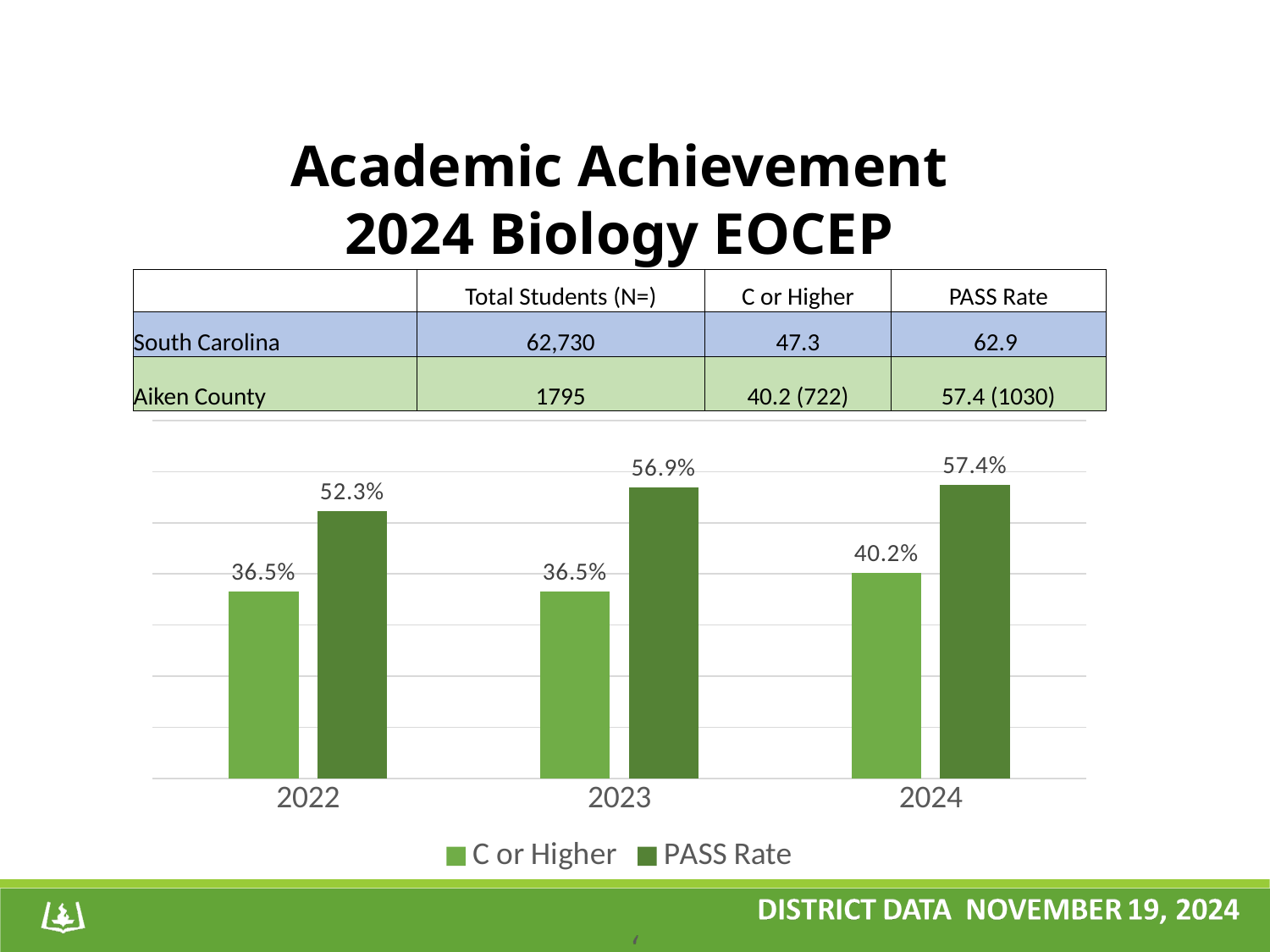
How many years are shown on the x axis of the chart? 3 What is the difference between the PASS Rate for 2023 and the PASS Rate for 2022? 4.6% Which is larger in the chart: the C or Higher value for 2024 or the C or Higher value for 2023? C or Higher for 2024 What kind of chart is shown on the slide? Bar chart What is the PASS Rate value for 2024 in the chart? 57.4% What is the C or Higher value for 2022 in the chart? 36.5% What is the PASS Rate value for 2023 in the chart? 56.9% Which year has the highest PASS Rate in the chart? 2024 How many series does the chart legend list? 2 Which year has the lowest PASS Rate in the chart? 2022 What is the difference between the PASS Rate and C or Higher values for 2024? 17.2% Does the PASS Rate rise or fall from 2022 to 2024 in the chart? Rise